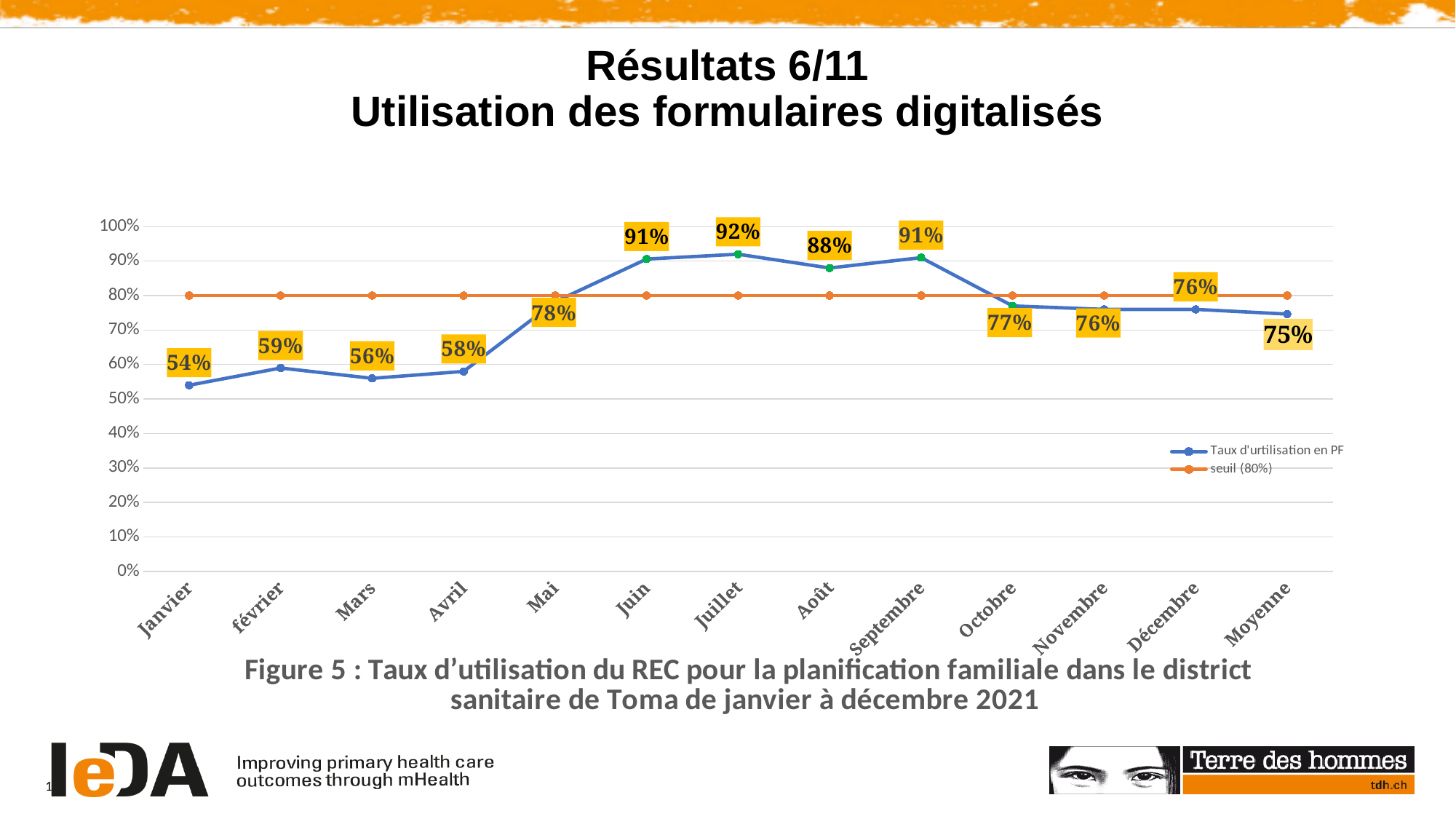
Which is larger, the Taux d'utilisation en PF for Août or for Octobre? Août What is the value of Taux d'utilisation en PF for Juillet? 92% What value does the seuil series represent, according to the legend? 80% How many categories are shown on the x axis? 13 What kind of chart is shown on the slide? line chart What is the value of Taux d'utilisation en PF for Janvier? 54% What is the Moyenne value for Taux d'utilisation en PF? 75% What is the difference between the Taux d'utilisation en PF for Juin and for Mai? 13% Which month has the highest Taux d'utilisation en PF? Juillet Which month has the lowest Taux d'utilisation en PF? Janvier How many series does the legend list? 2 Is the Taux d'utilisation en PF for Septembre greater or less than 80%? greater